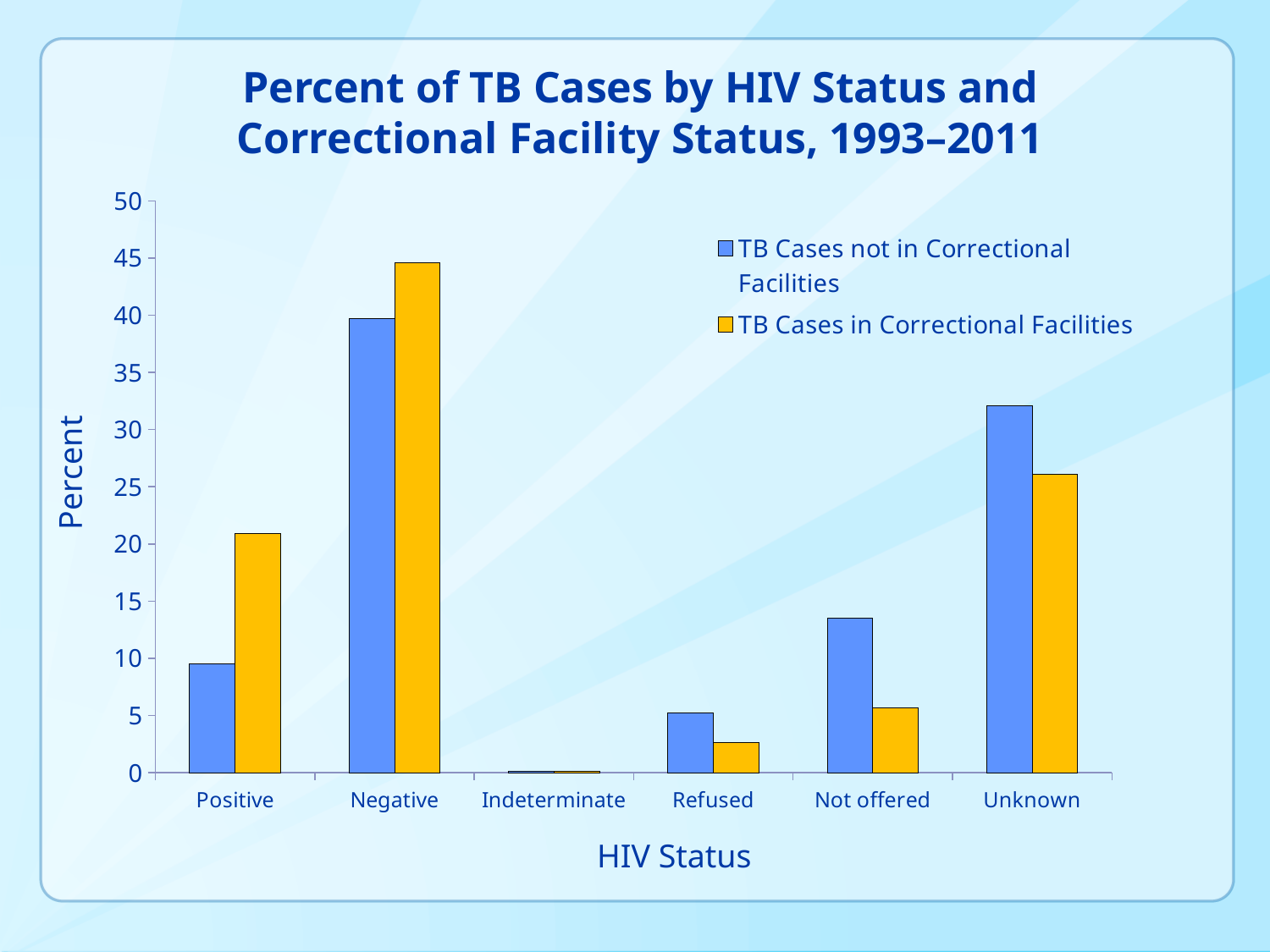
For the Unknown category, which series has the larger value: TB Cases not in Correctional Facilities or TB Cases in Correctional Facilities? TB Cases not in Correctional Facilities How many series does the legend list? 2 Which HIV status category has the highest value for TB Cases in Correctional Facilities? Negative Is the value for TB Cases in Correctional Facilities in the Negative category greater or less than 40? greater Is the value for TB Cases not in Correctional Facilities in the Not offered category greater or less than 10? greater For the Positive category, which series has the larger value: TB Cases not in Correctional Facilities or TB Cases in Correctional Facilities? TB Cases in Correctional Facilities What colour are the bars for TB Cases in Correctional Facilities? yellow How many HIV status categories are shown on the x axis? 6 Is the value for TB Cases in Correctional Facilities in the Refused category greater or less than 5? less Which HIV status category has the lowest value for TB Cases not in Correctional Facilities? Indeterminate What kind of chart is shown on the slide? bar chart What is the label of the y axis? Percent